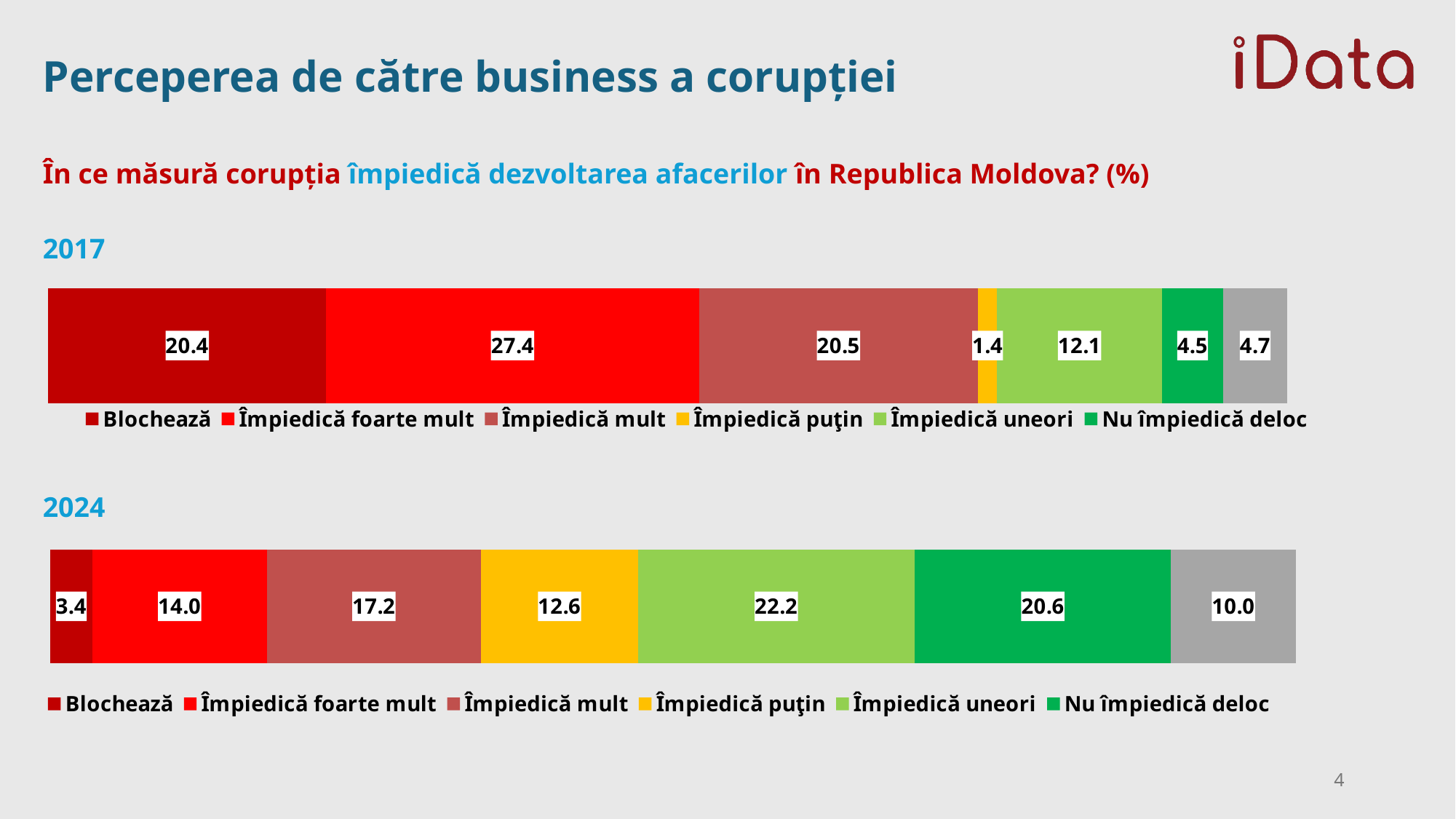
In the 2024 chart, what is the value for "Împiedică uneori"? 22.2 In the 2017 chart, which legend category has the lowest value? Împiedică puţin What type of chart is used to show the 2017 data? Stacked bar chart In the 2017 chart, which legend category has the highest value? Împiedică foarte mult In the 2024 chart, what is the value for "Blochează"? 3.4 What is the difference between the "Nu împiedică deloc" value in 2024 and in 2017? 16.1 What is the difference between the "Blochează" value in 2017 and in 2024? 17.0 What is the total of all segments in the 2024 stacked bar? 100.0 In the 2017 chart, what is the value for "Împiedică foarte mult"? 27.4 In the 2024 chart, which legend category has the highest value? Împiedică uneori In the 2024 chart, which is larger: "Împiedică mult" or "Împiedică puţin"? Împiedică mult How many entries does the legend of the 2024 chart list? 6